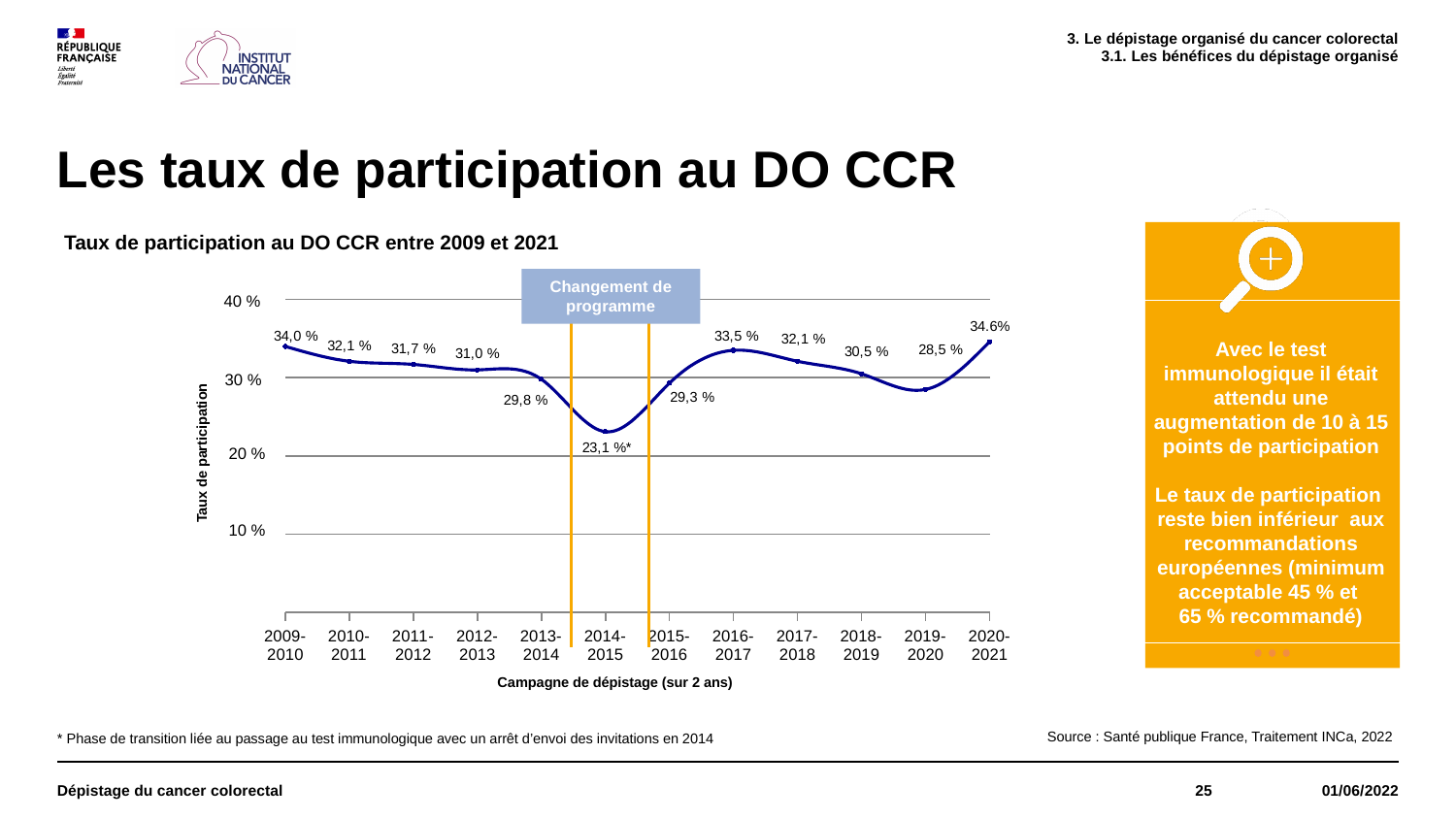
Is the participation rate for the 2014-2015 campaign greater or less than 30 %? less Which campaign has the highest participation rate? 2020-2021 Which campaign has a higher participation rate, 2016-2017 or 2019-2020? 2016-2017 What is the participation rate for the 2014-2015 campaign? 23,1 % What is the participation rate for the 2009-2010 campaign? 34,0 % How many campaigns are plotted on the x axis? 12 Which campaign has the lowest participation rate? 2014-2015 What does the annotation between the two vertical orange lines on the chart say? Changement de programme What is the participation rate for the 2020-2021 campaign? 34.6% What type of chart is shown on the slide? Line chart What is the difference in participation rate between the 2009-2010 and 2014-2015 campaigns? 10,9 points What is the participation rate for the 2016-2017 campaign? 33,5 %